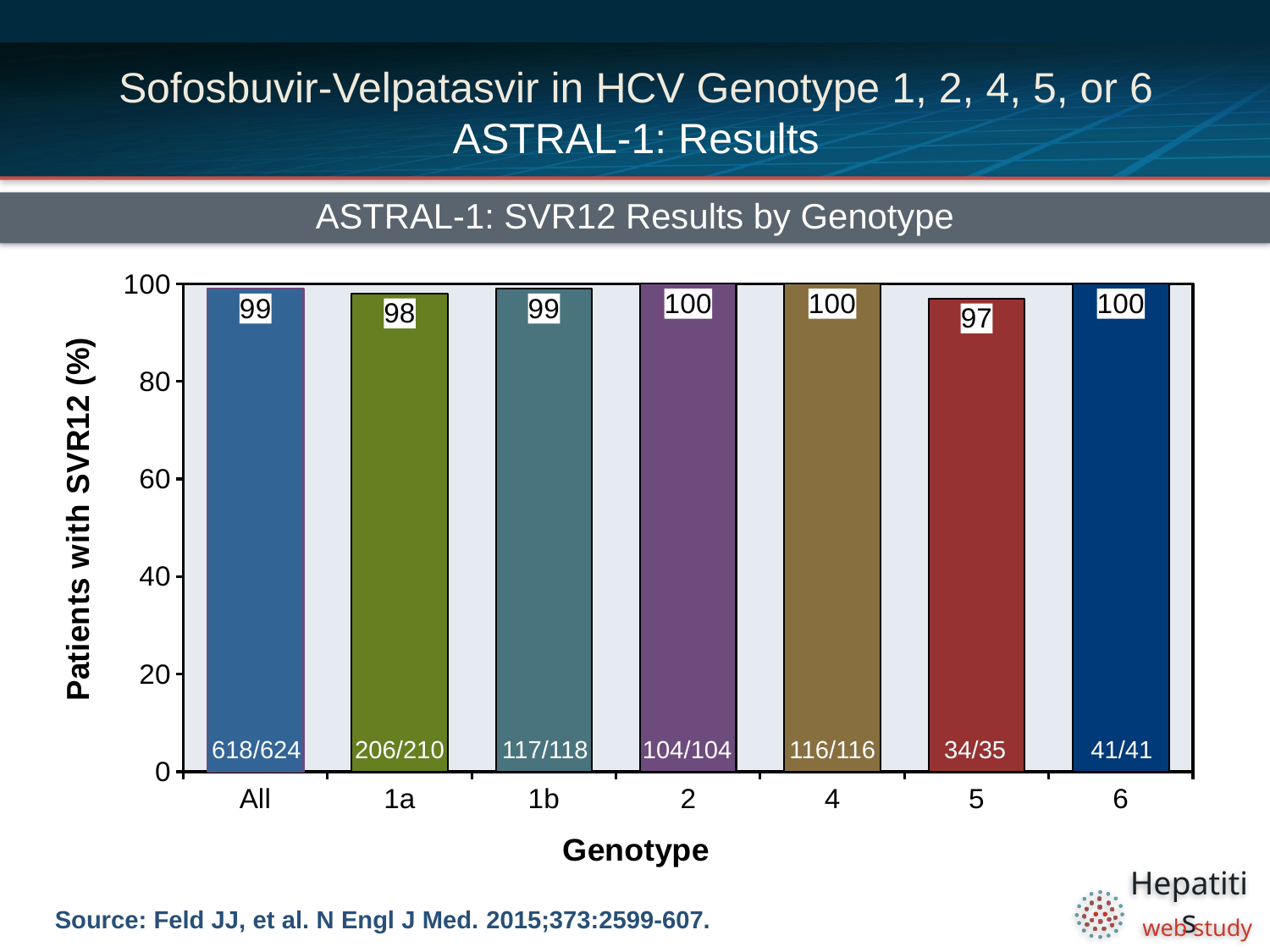
What is the difference in SVR12 rate between genotype 2 and genotype 5? 3 What fraction of patients achieved SVR12 in genotype 1b? 117/118 What is the SVR12 rate (%) for the All group? 99 What fraction of patients achieved SVR12 in genotype 5? 34/35 How many genotype categories are shown on the x axis? 7 What is the SVR12 rate (%) for genotype 1a? 98 What is the SVR12 rate (%) for genotype 5? 97 What is the label of the y axis? Patients with SVR12 (%) How many genotype groups have an SVR12 rate of 100%? 3 Which genotype has the lowest SVR12 rate? 5 Which has a higher SVR12 rate, genotype 1a or genotype 4? Genotype 4 What type of chart is shown on the slide? Bar chart